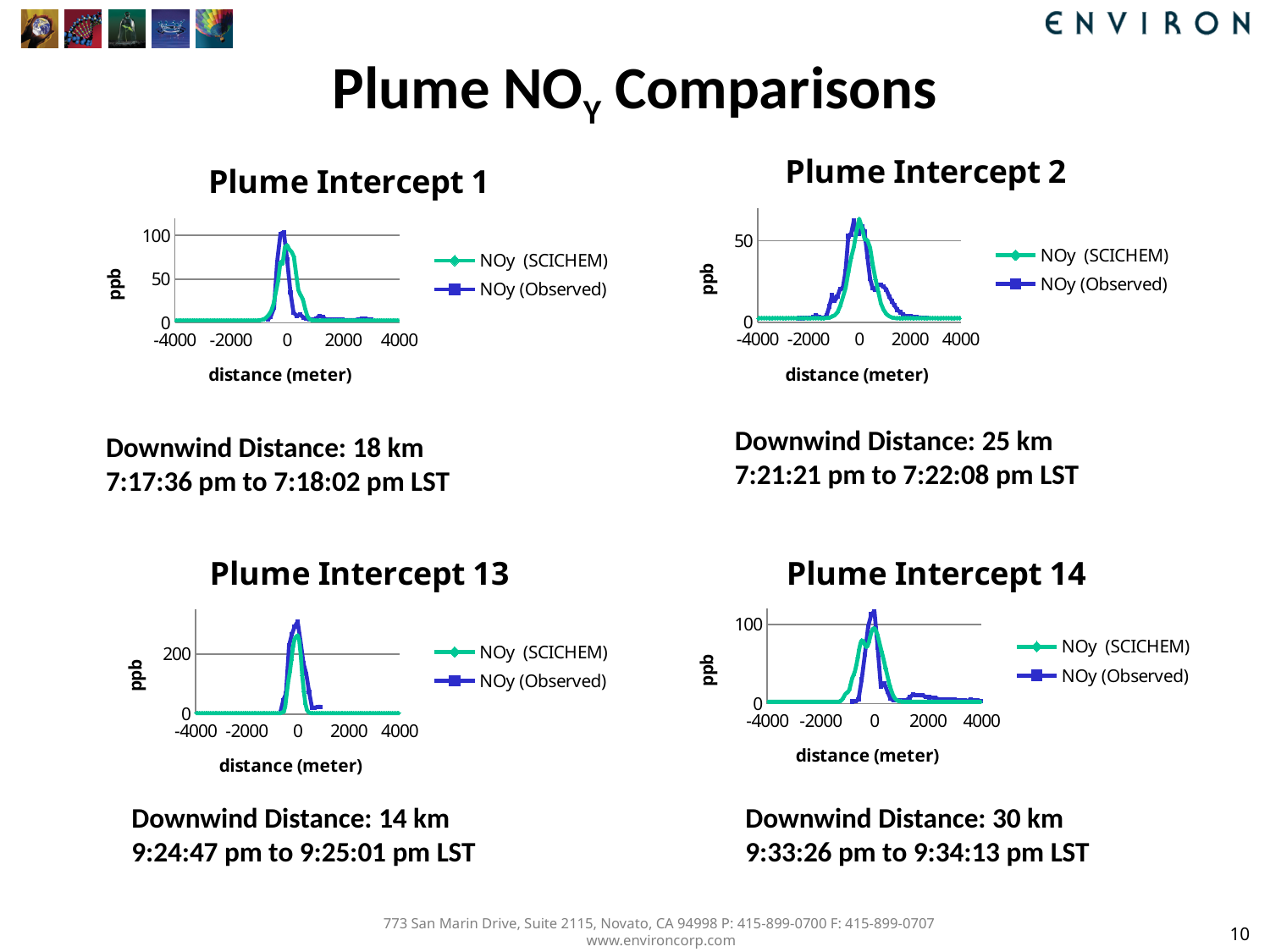
In the Plume Intercept 13 chart, is the peak value of NOy (Observed) greater or less than 200? greater In the Plume Intercept 2 chart, is the peak value of NOy (Observed) greater or less than 50? greater In the Plume Intercept 14 chart, is the peak value of NOy (Observed) greater or less than 100? greater In the Plume Intercept 1 chart, which series reaches the higher peak, NOy (SCICHEM) or NOy (Observed)? NOy (Observed) What kind of chart is Plume Intercept 1? line chart What are the two series named in the legend of the Plume Intercept 13 chart? NOy (SCICHEM) and NOy (Observed) How many charts are shown on the slide? 4 What is the x-axis label on the Plume Intercept 14 chart? distance (meter) In the Plume Intercept 14 chart, which series reaches the higher peak, NOy (SCICHEM) or NOy (Observed)? NOy (Observed) How many series does the legend of the Plume Intercept 2 chart list? 2